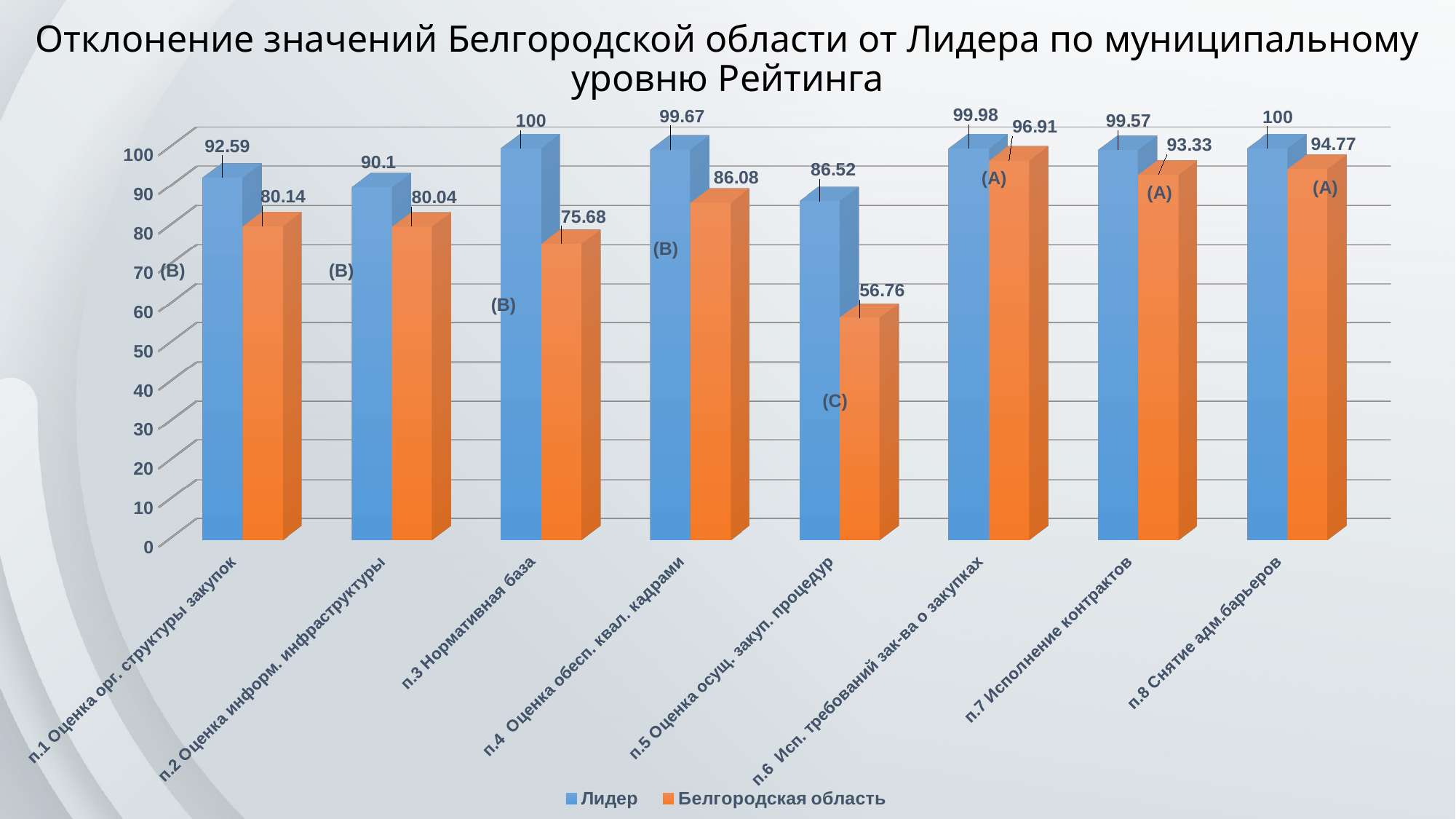
What is the difference between Лидер and Белгородская область in п.7 Исполнение контрактов? 6.24 What is the value for Лидер in п.4 Оценка обесп. квал. кадрами? 99.67 Which series is shown in orange in the legend? Белгородская область How many categories are shown on the x axis? 8 How many series does the legend list? 2 What is the difference between Лидер and Белгородская область in п.3 Нормативная база? 24.32 Which category has the lowest value for Белгородская область? п.5 Оценка осущ. закуп. процедур Which category has the lowest value for Лидер? п.5 Оценка осущ. закуп. процедур Which is larger: the Белгородская область value for п.1 Оценка орг. структуры закупок or for п.4 Оценка обесп. квал. кадрами? п.4 Оценка обесп. квал. кадрами What is the value for Белгородская область in п.5 Оценка осущ. закуп. процедур? 56.76 What kind of chart is shown on the slide? Bar chart What is the value for Белгородская область in п.6 Исп. требований зак-ва о закупках? 96.91